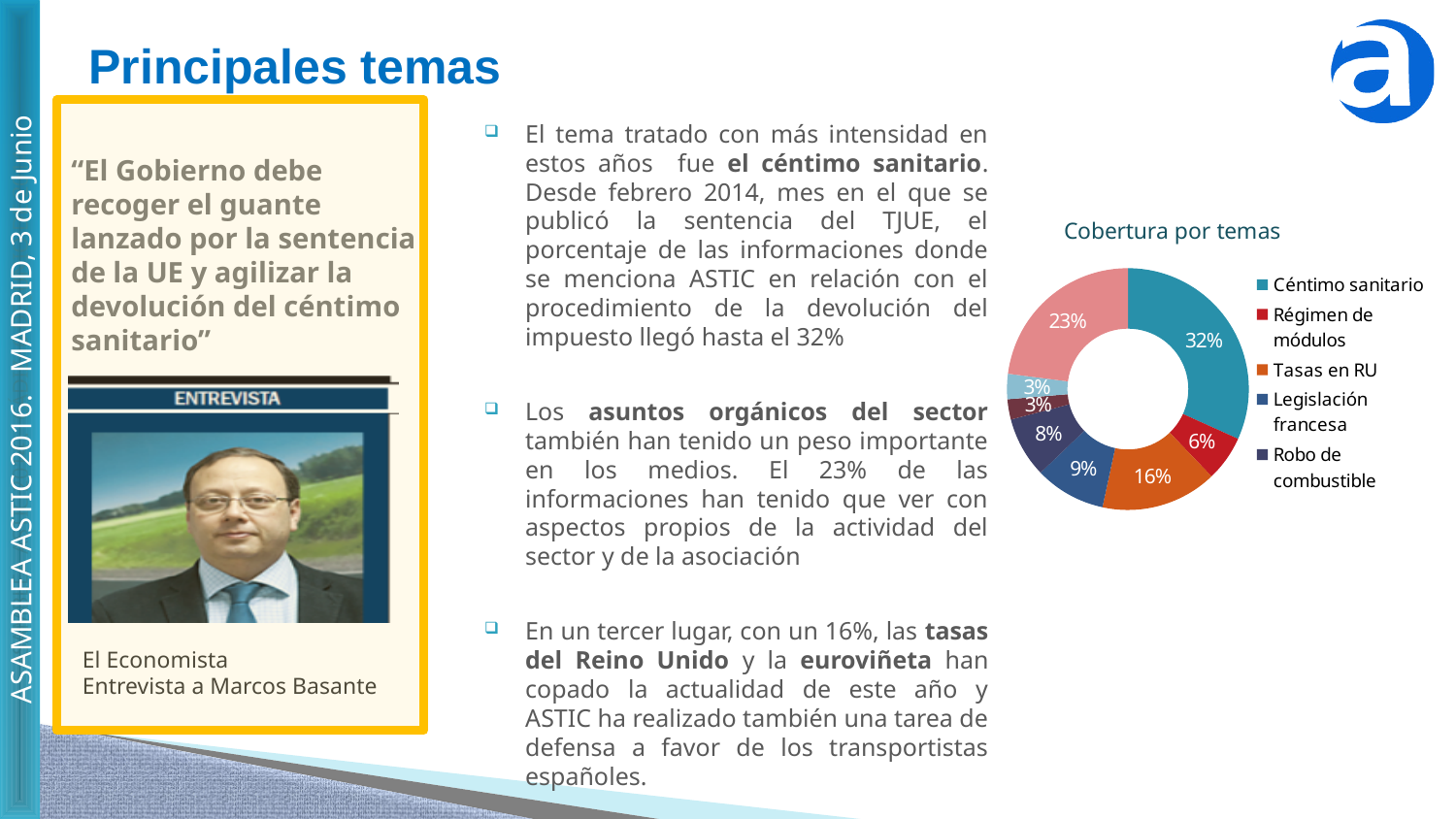
In the "Cobertura por temas" chart, what percentage is shown for Régimen de módulos? 6% How many slices does the "Cobertura por temas" chart have? 8 In the "Cobertura por temas" chart, how many percentage points larger is Céntimo sanitario than Tasas en RU? 16 percentage points What kind of chart is shown under the title "Cobertura por temas"? Pie (doughnut) chart Which topic has the largest slice in the "Cobertura por temas" chart? Céntimo sanitario In the "Cobertura por temas" chart, what percentage is shown for Céntimo sanitario? 32% In the "Cobertura por temas" chart, what percentage is shown for Legislación francesa? 9% In the "Cobertura por temas" chart, what percentage is shown for Robo de combustible? 8% In the "Cobertura por temas" chart, which slice is larger: Tasas en RU or Legislación francesa? Tasas en RU What is the title of the chart on the slide? Cobertura por temas How many entries does the legend of the "Cobertura por temas" chart list? 5 In the "Cobertura por temas" chart, what percentage is shown for Tasas en RU? 16%